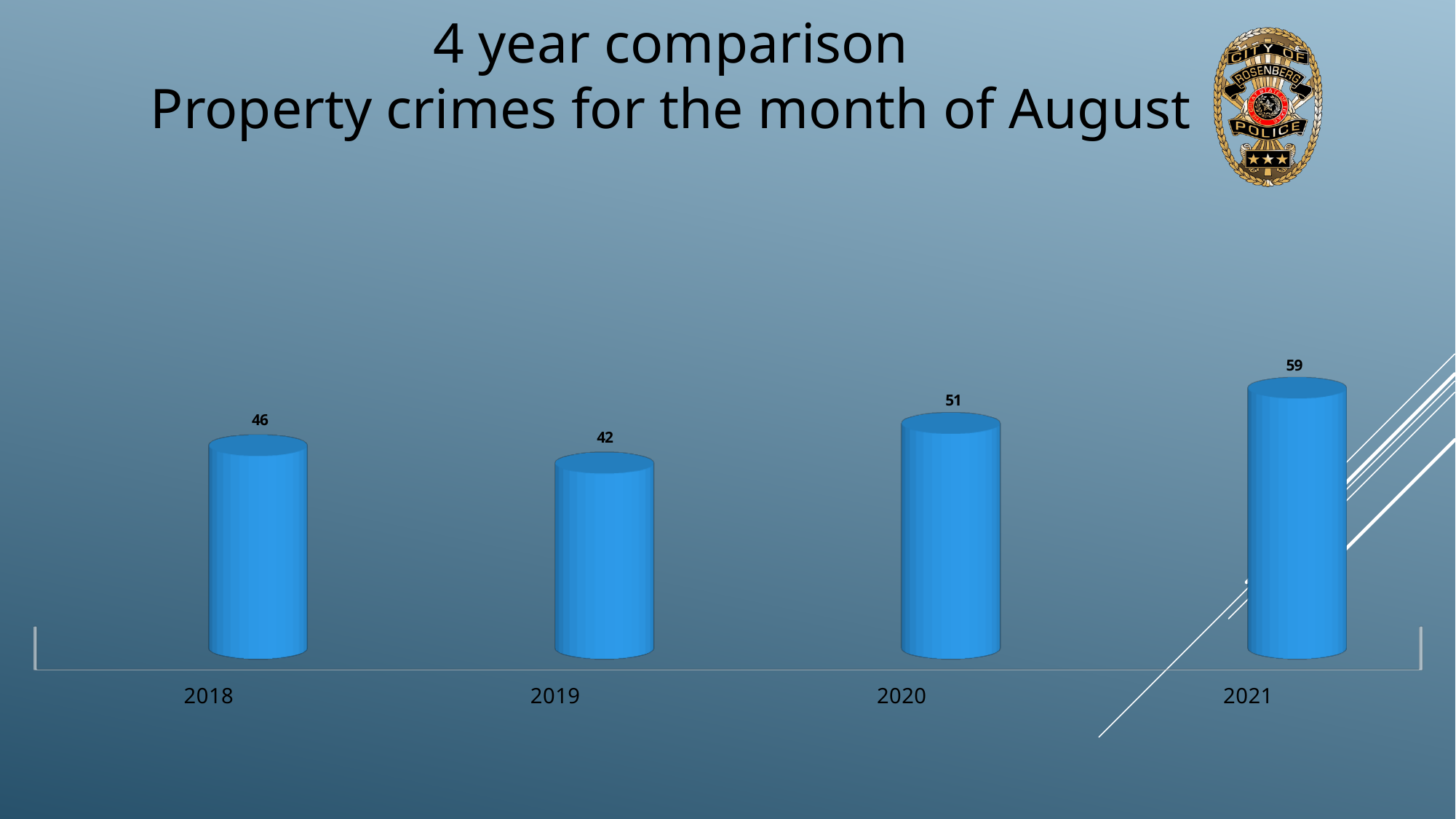
What is the value for 2020? 51 What kind of chart is shown on the slide? bar chart What is the title of the slide? 4 year comparison Property crimes for the month of August What is the difference between the values for 2020 and 2019? 9 Which year has the lowest value? 2019 What is the value for 2018? 46 What is the value for 2021? 59 What is the difference between the values for 2021 and 2018? 13 Which year has the highest value? 2021 Which is larger, the value for 2018 or the value for 2020? 2020 What is the value for 2019? 42 How many years are shown on the chart? 4